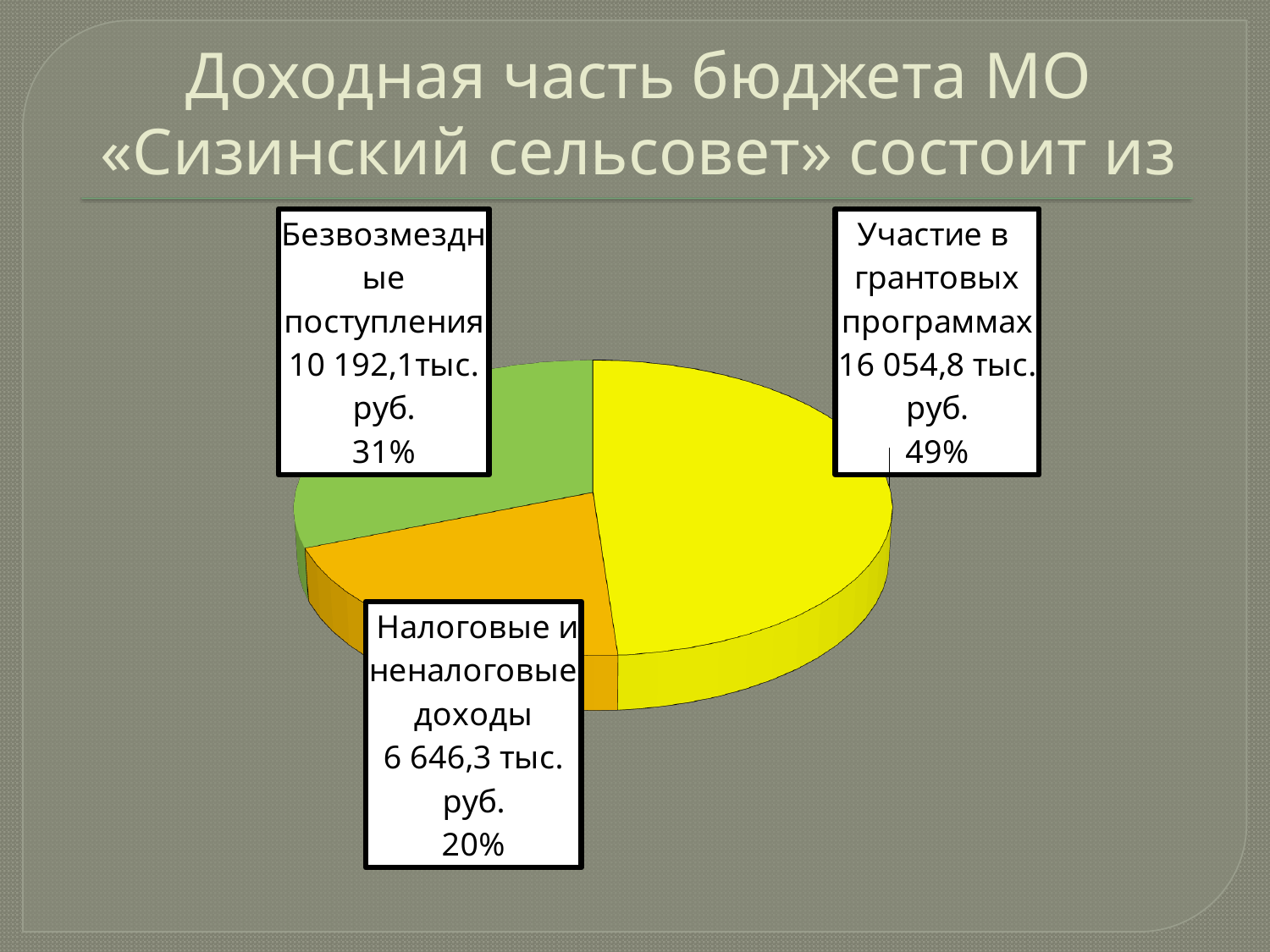
What colour is the slice for Участие в грантовых программах? yellow What is the value for Безвозмездные поступления? 10 192,1 тыс. руб. How many slices does the pie chart have? 3 What is the value for Налоговые и неналоговые доходы? 6 646,3 тыс. руб. What is the difference between Участие в грантовых программах and Безвозмездные поступления? 5 862,7 тыс. руб. What kind of chart is shown on the slide? pie chart What share of the pie does Налоговые и неналоговые доходы represent? 20% Which is larger, Безвозмездные поступления or Налоговые и неналоговые доходы? Безвозмездные поступления Which category has the smallest slice of the pie? Налоговые и неналоговые доходы What share of the pie does Участие в грантовых программах represent? 49% Which category has the largest slice of the pie? Участие в грантовых программах What is the value for Участие в грантовых программах? 16 054,8 тыс. руб.